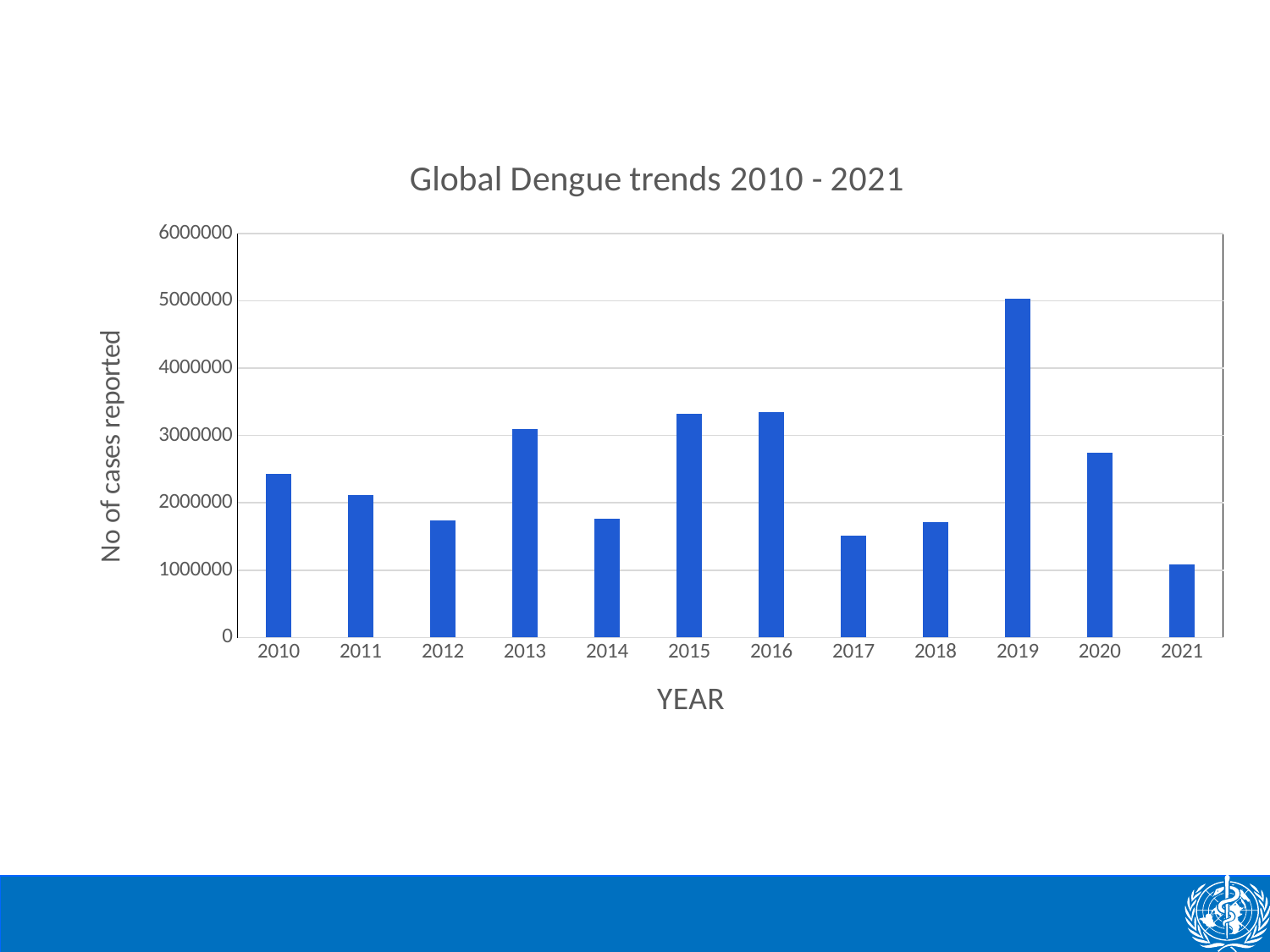
What is the label of the y axis? No of cases reported What type of chart is shown on the slide? bar chart Is the value for 2017 greater or less than 2000000? less Which year has more cases reported, 2013 or 2014? 2013 Is the value for 2010 greater or less than 2000000? greater Which year has the highest number of cases reported? 2019 Which year has the lowest number of cases reported? 2021 Is the value for 2020 greater or less than 3000000? less What is the title of the chart? Global Dengue trends 2010 - 2021 How many years are shown on the x axis? 12 Which year has more cases reported, 2020 or 2021? 2020